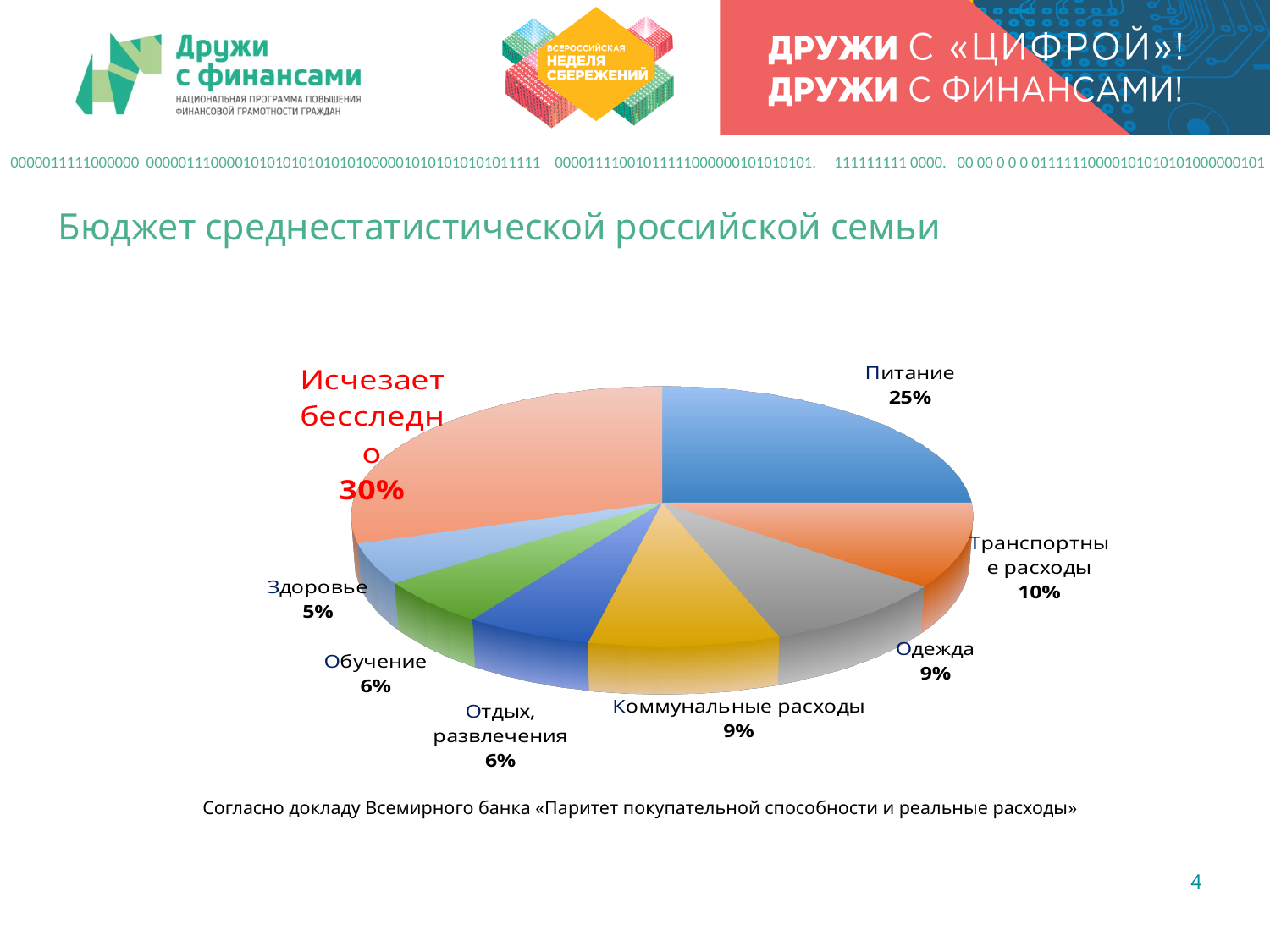
What kind of chart is shown on the slide? pie chart What is the combined share of Одежда and Коммунальные расходы? 18% What is the title of the chart on the slide? Бюджет среднестатистической российской семьи What share of the budget is labelled Исчезает бесследно? 30% Which category has the smallest share of the budget? Здоровье What share of the budget goes to Транспортные расходы? 10% Which category has the largest share of the budget? Исчезает бесследно What share of the budget goes to Здоровье? 5% What is the difference between the shares for Питание and Транспортные расходы? 15% What share of the budget goes to Питание? 25% How many slices does the pie chart have? 8 Which is larger, the share for Одежда or the share for Обучение? Одежда